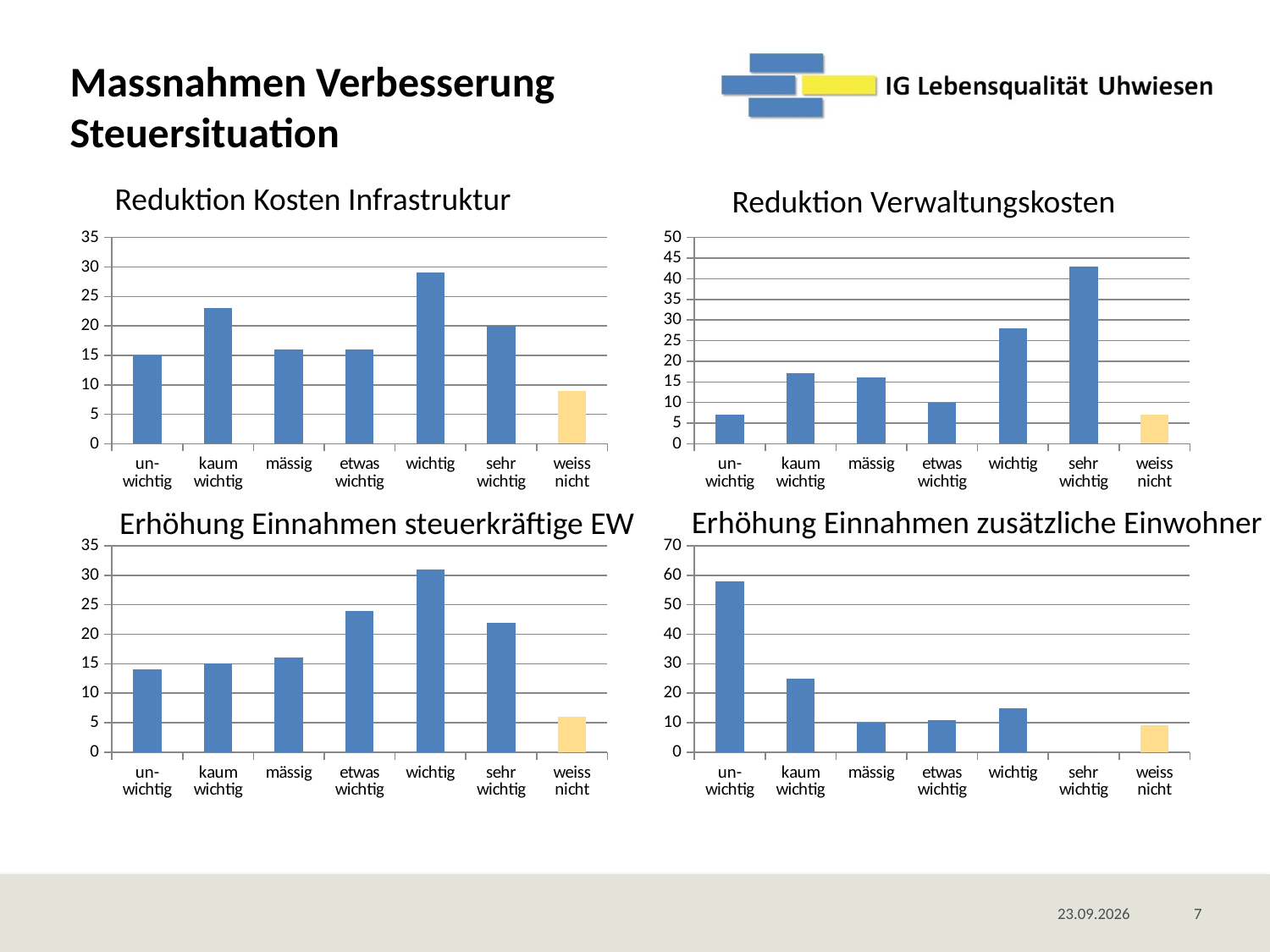
In the "Erhöhung Einnahmen zusätzliche Einwohner" chart, which is larger, the value for "kaum wichtig" or the value for "wichtig"? kaum wichtig In the "Reduktion Verwaltungskosten" chart, what is the value for "etwas wichtig"? 10 In the "Reduktion Verwaltungskosten" chart, which category has the highest value? sehr wichtig In the "Reduktion Kosten Infrastruktur" chart, what is the value for "sehr wichtig"? 20 In the "Erhöhung Einnahmen zusätzliche Einwohner" chart, is the value for "un-wichtig" greater or less than 50? greater In the "Reduktion Kosten Infrastruktur" chart, which category has the lowest value? weiss nicht How many categories are shown on the x axis of the "Erhöhung Einnahmen steuerkräftige EW" chart? 7 In the "Erhöhung Einnahmen zusätzliche Einwohner" chart, which category has the highest value? un-wichtig What type of chart is "Reduktion Kosten Infrastruktur"? bar chart In the "Reduktion Kosten Infrastruktur" chart, which category has the highest value? wichtig In the "Reduktion Verwaltungskosten" chart, is the value for "sehr wichtig" greater or less than 40? greater